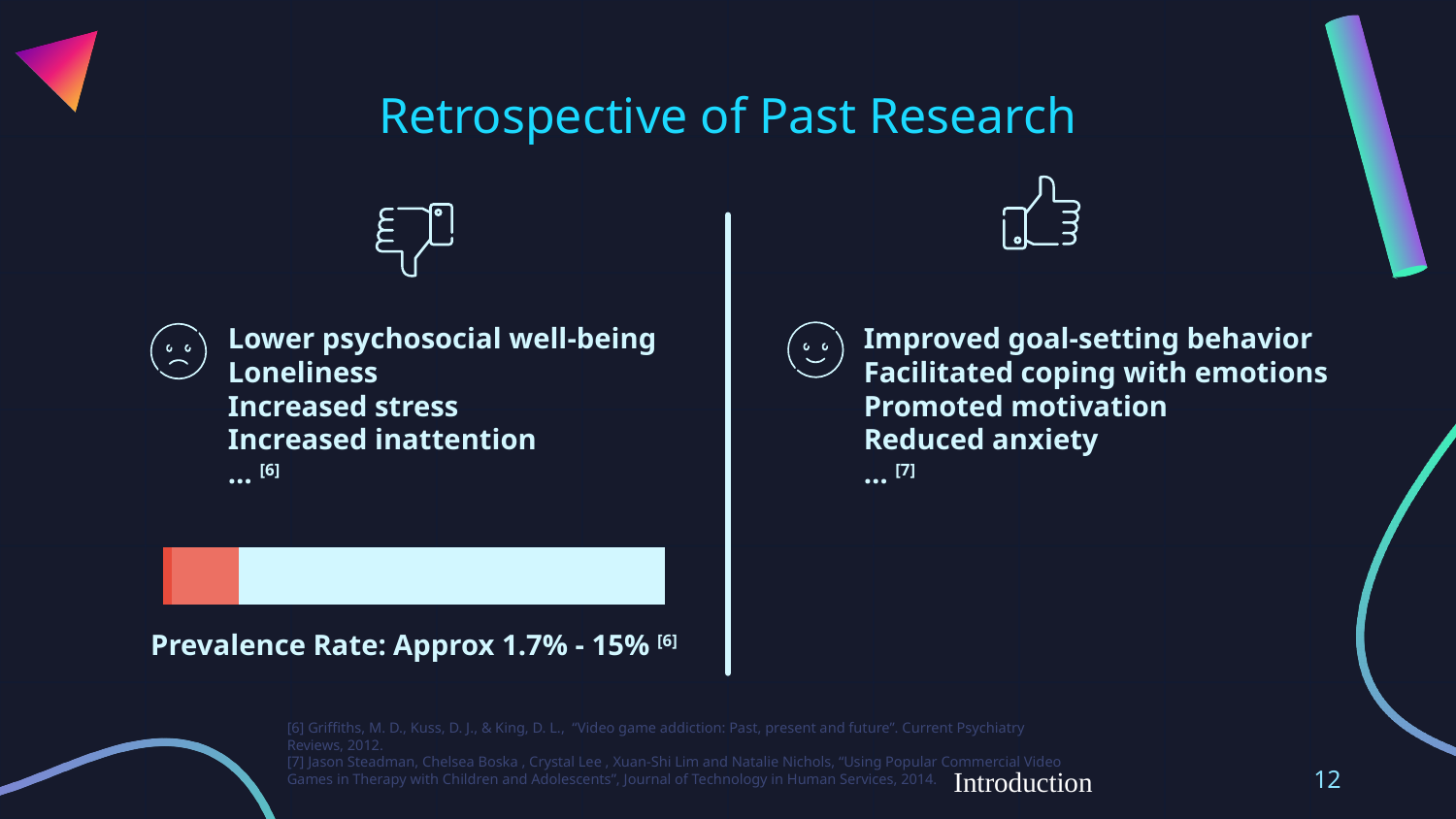
What label is printed directly below the horizontal bar on the left side of the slide? Prevalence Rate: Approx 1.7% - 15% What colour is the filled (left-hand) segment of the prevalence rate bar? red What kind of chart is shown at the bottom left of the slide, below the list of negative effects? bar chart How many bars are drawn in the chart on the left side of the slide? 1 In the horizontal bar on the left side of the slide, which portion is larger, the red portion or the light blue portion? the light blue portion